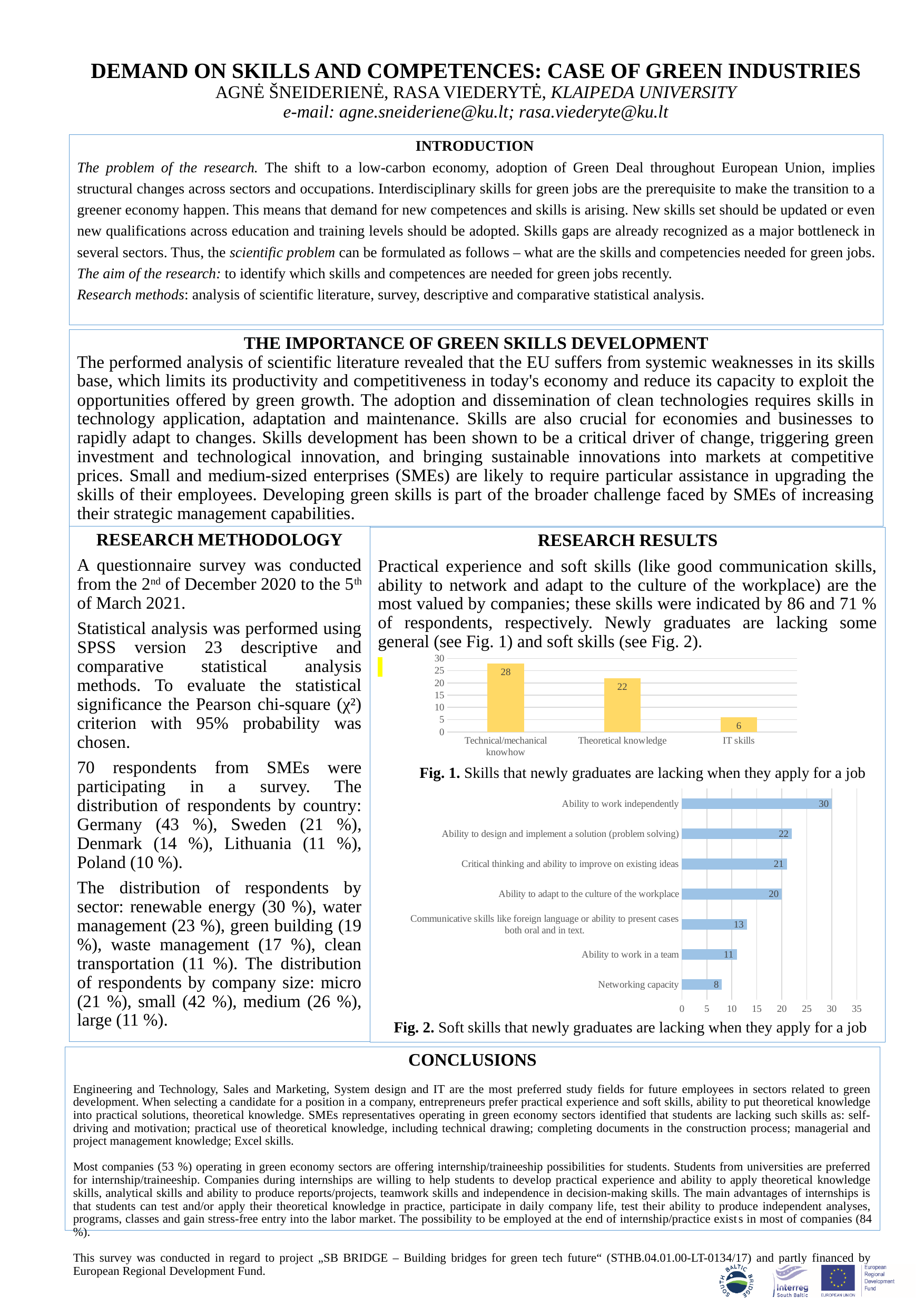
In Fig. 2, what is the difference between Ability to work independently and Ability to adapt to the culture of the workplace? 10 In Fig. 1, what is the difference between Technical/mechanical knowhow and IT skills? 22 In Fig. 1, which category has the highest value? Technical/mechanical knowhow In Fig. 2, what is the value for Ability to work in a team? 11 In Fig. 2, which is larger: Critical thinking and ability to improve on existing ideas or Communicative skills like foreign language or ability to present cases both oral and in text? Critical thinking and ability to improve on existing ideas In Fig. 1, what is the value for Theoretical knowledge? 22 In Fig. 2, which category has the lowest value? Networking capacity What kind of chart is Fig. 1? bar chart In Fig. 2, which category has the highest value? Ability to work independently In Fig. 1, how many categories are shown? 3 In Fig. 1, which category has the lowest value? IT skills In Fig. 2, how many categories are shown? 7